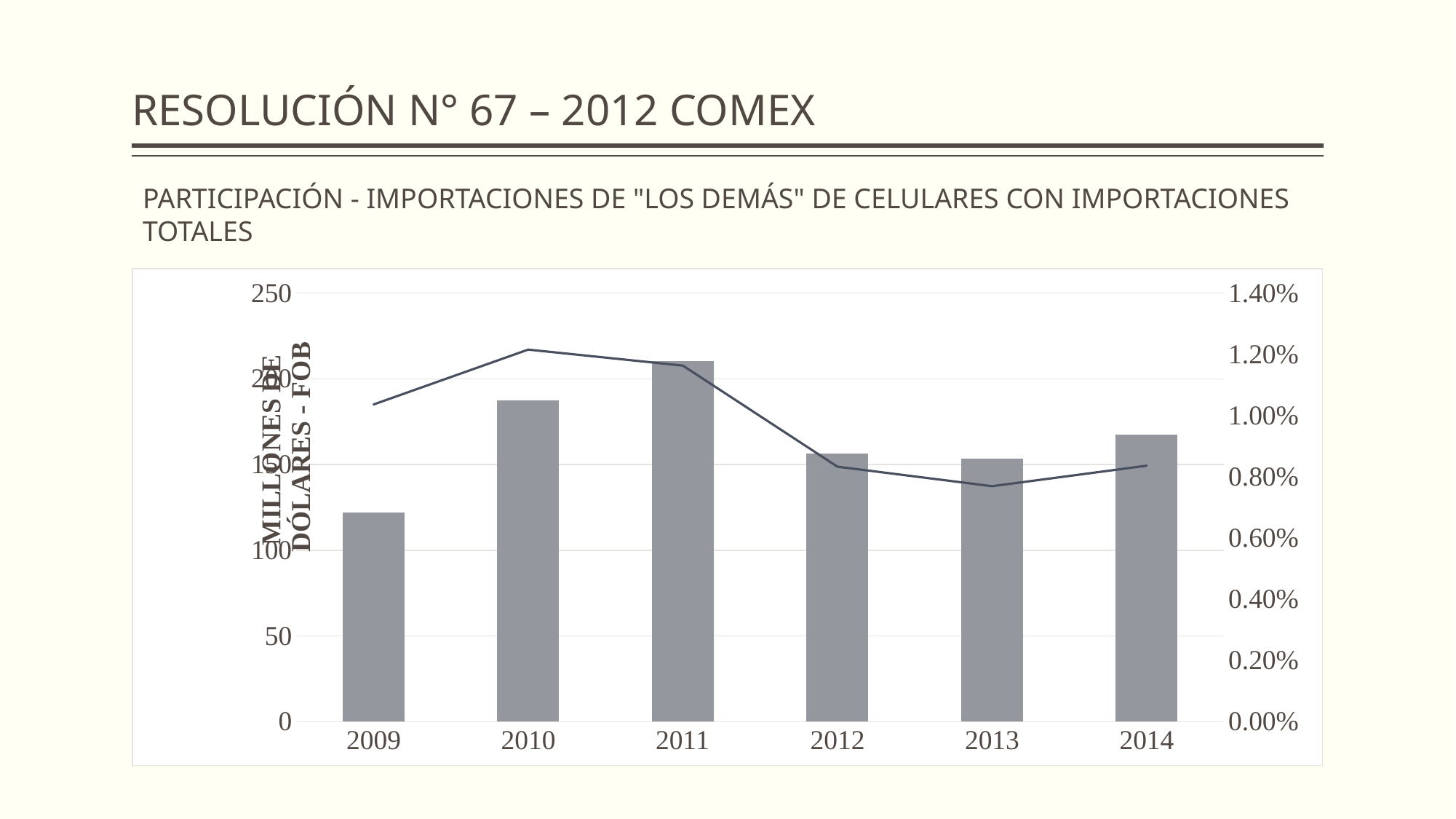
What kind of chart is shown on the slide? A bar chart combined with a line chart Is the bar value for 2011 greater or less than 200? greater Is the bar value for 2014 greater or less than 150? greater Is the line value for 2012 greater or less than 1.00%? less Which year has the tallest bar? 2011 Which year has the highest point on the line series? 2010 What is the title of the left vertical axis? MILLONES DE DÓLARES - FOB How many years are shown on the x axis of the chart? 6 Which year has the lowest point on the line series? 2013 Which bar is taller, 2010 or 2014? 2010 Which year has the shortest bar? 2009